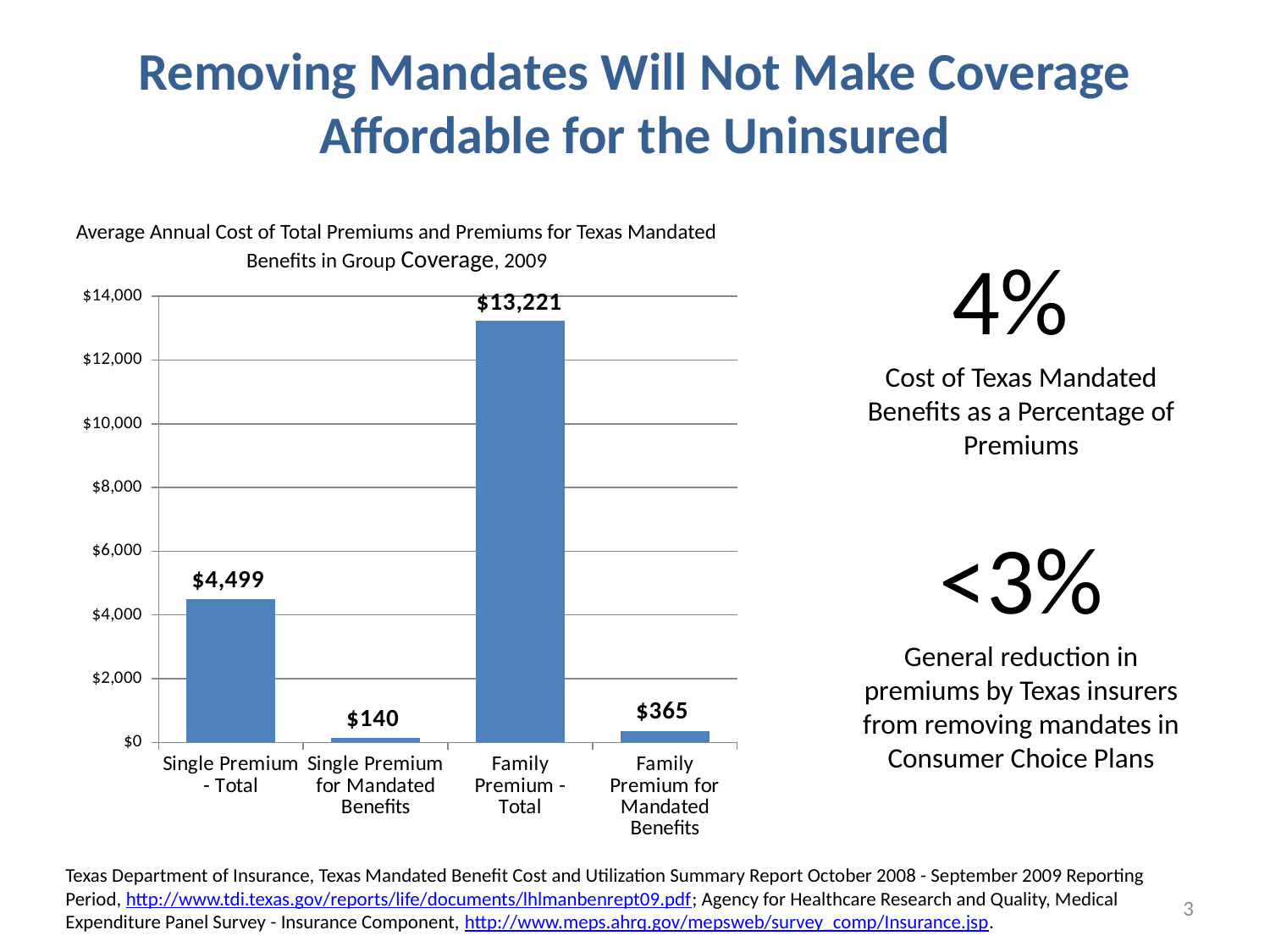
What is the value for Family Premium for Mandated Benefits? $365 Is the value for Family Premium - Total greater or less than $12,000? greater What is the difference between Family Premium for Mandated Benefits and Single Premium for Mandated Benefits? $225 What is the value for Single Premium - Total? $4,499 What is the value for Single Premium for Mandated Benefits? $140 Which category has the lowest value? Single Premium for Mandated Benefits What kind of chart is shown on the slide? bar chart How many categories are shown in the chart? 4 What is the title of the chart? Average Annual Cost of Total Premiums and Premiums for Texas Mandated Benefits in Group Coverage, 2009 What is the difference between Family Premium - Total and Single Premium - Total? $8,722 Which category has the highest value? Family Premium - Total Which is larger, Single Premium - Total or Family Premium for Mandated Benefits? Single Premium - Total